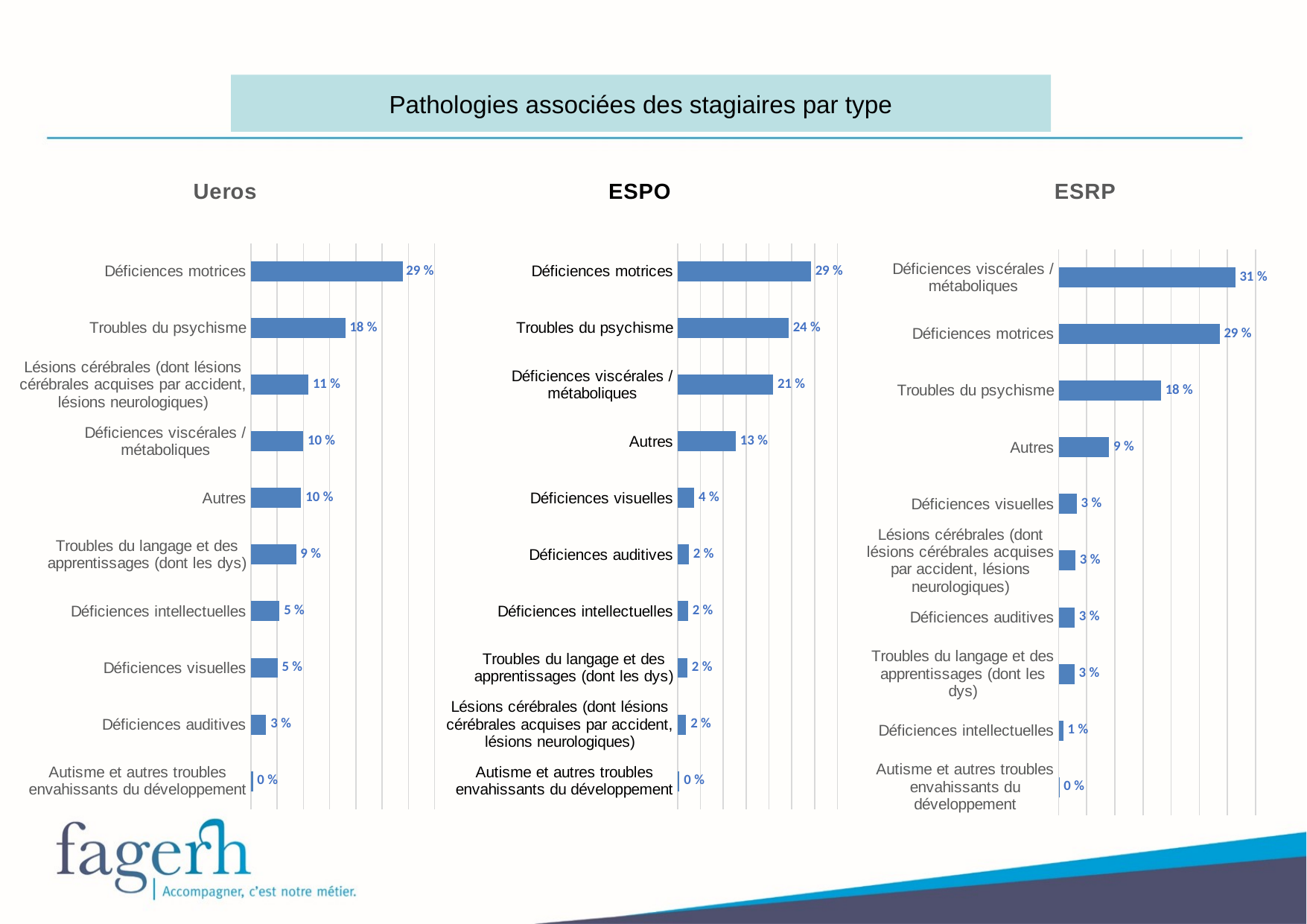
In the ESRP chart, what is the value for Déficiences intellectuelles? 1 % In the ESPO chart, which category has the lowest value? Autisme et autres troubles envahissants du développement In the ESPO chart, what is the difference between Déficiences motrices and Déficiences visuelles? 25 % In the Ueros chart, what is the difference between Déficiences motrices and Troubles du psychisme? 11 % In the ESRP chart, which category has the highest value? Déficiences viscérales / métaboliques In the ESPO chart, which is larger: Déficiences viscérales / métaboliques or Autres? Déficiences viscérales / métaboliques What is the title of the slide above the three charts? Pathologies associées des stagiaires par type What kind of chart is the ESPO chart? Bar chart In the ESRP chart, what is the value for Déficiences viscérales / métaboliques? 31 % In the ESPO chart, what is the value for Troubles du psychisme? 24 % In the Ueros chart, what is the value for Déficiences motrices? 29 % How many categories does the Ueros chart show? 10